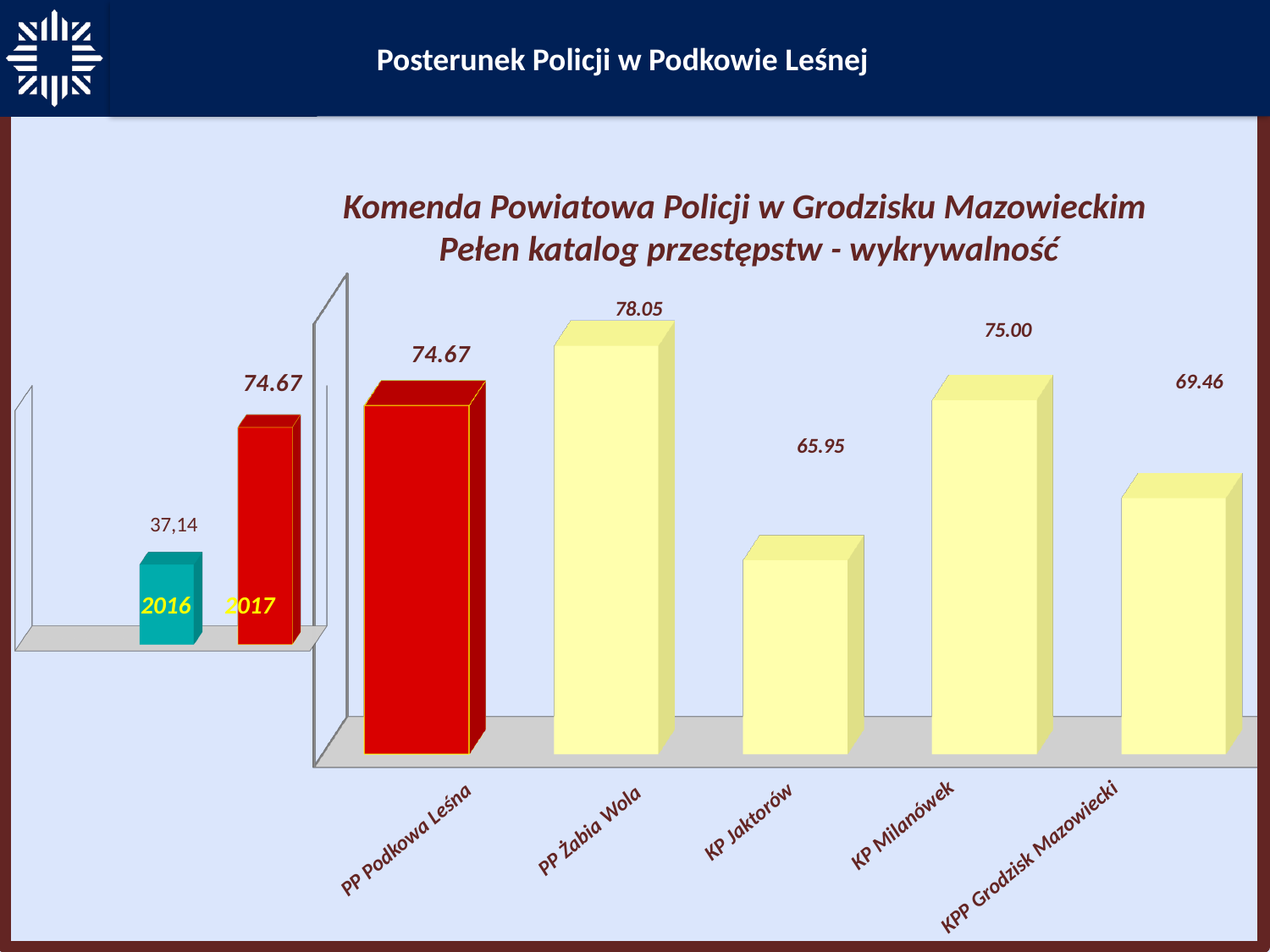
In the large chart titled 'Komenda Powiatowa Policji w Grodzisku Mazowieckim Pełen katalog przestępstw - wykrywalność', what is the value for PP Żabia Wola? 78.05 In the small chart on the left, what is the value for 2017? 74.67 How many categories are shown in the large chart on the right? 5 In the large chart on the right, which category has the highest value? PP Żabia Wola In the large chart on the right, which is larger: the value for KP Milanówek or the value for PP Podkowa Leśna? KP Milanówek In the large chart on the right, what is the value for KP Jaktorów? 65.95 In the small chart on the left, which year has the higher value, 2016 or 2017? 2017 In the large chart on the right, what is the difference between the values for PP Żabia Wola and KP Milanówek? 3.05 In the small chart on the left, what is the value for 2016? 37,14 In the large chart on the right, which category has the lowest value? KP Jaktorów In the large chart on the right, what is the value for KPP Grodzisk Mazowiecki? 69.46 What kind of chart is the large chart on the right? bar chart